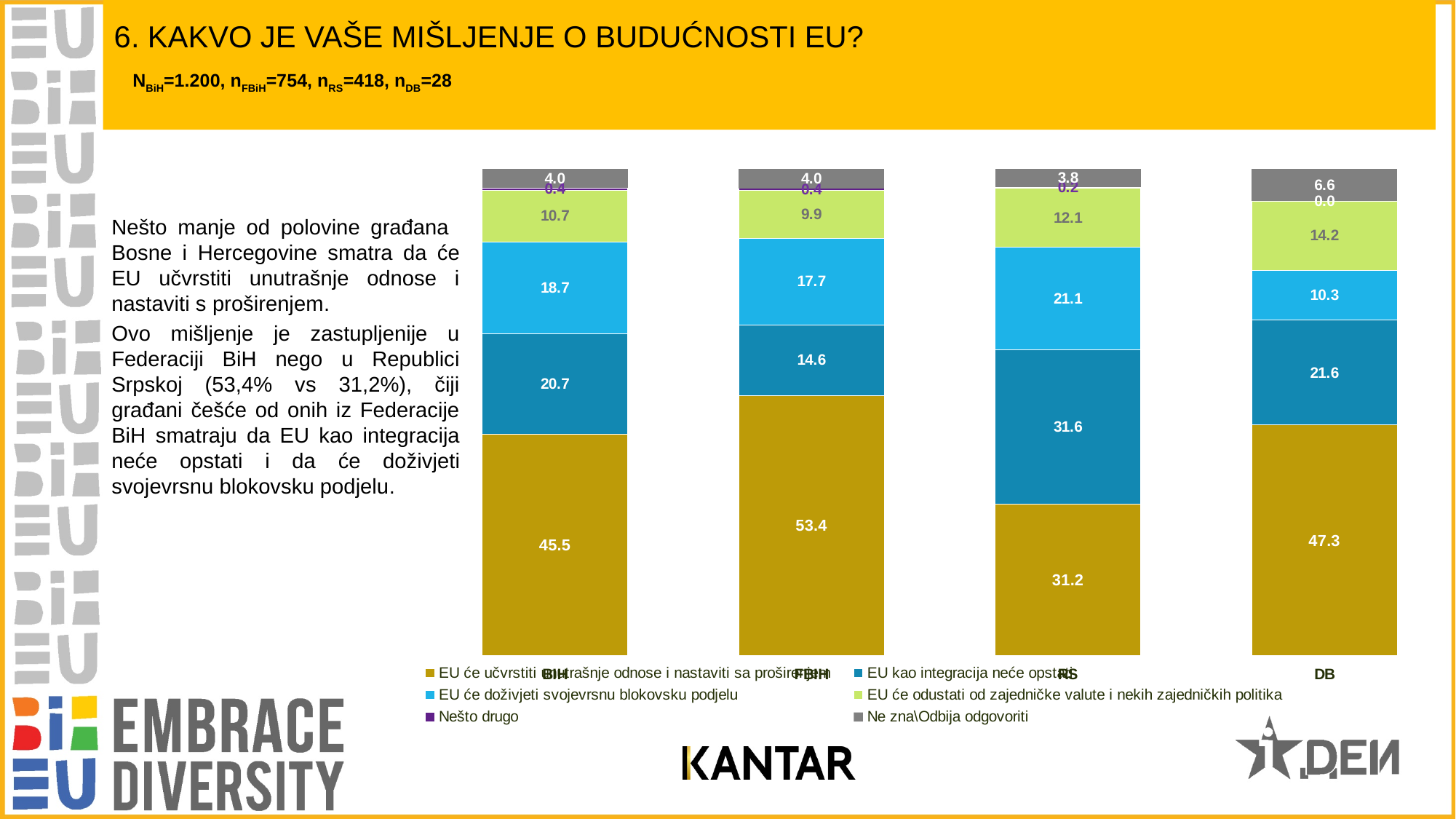
What is the difference between the FBiH and RS values for 'EU će učvrstiti unutrašnje odnose i nastaviti sa proširenjem'? 22.2 What is the value for 'EU će učvrstiti unutrašnje odnose i nastaviti sa proširenjem' in the FBiH bar? 53.4 What is the value for 'Ne zna\Odbija odgovoriti' in the DB bar? 6.6 How many series does the chart legend list? 6 Which is larger: the 'EU kao integracija neće opstati' value for BiH or for FBiH? BiH How many categories (bars) are shown on the x axis of the chart? 4 What type of chart is shown on the slide? stacked bar chart Which category has the lowest value for 'EU će doživjeti svojevrsnu blokovsku podjelu'? DB Which category has the highest value for 'EU će učvrstiti unutrašnje odnose i nastaviti sa proširenjem'? FBiH What is the value for 'EU kao integracija neće opstati' in the RS bar? 31.6 What is the value for 'EU će doživjeti svojevrsnu blokovsku podjelu' in the BiH bar? 18.7 What is the total of the stacked bar for RS? 100.0